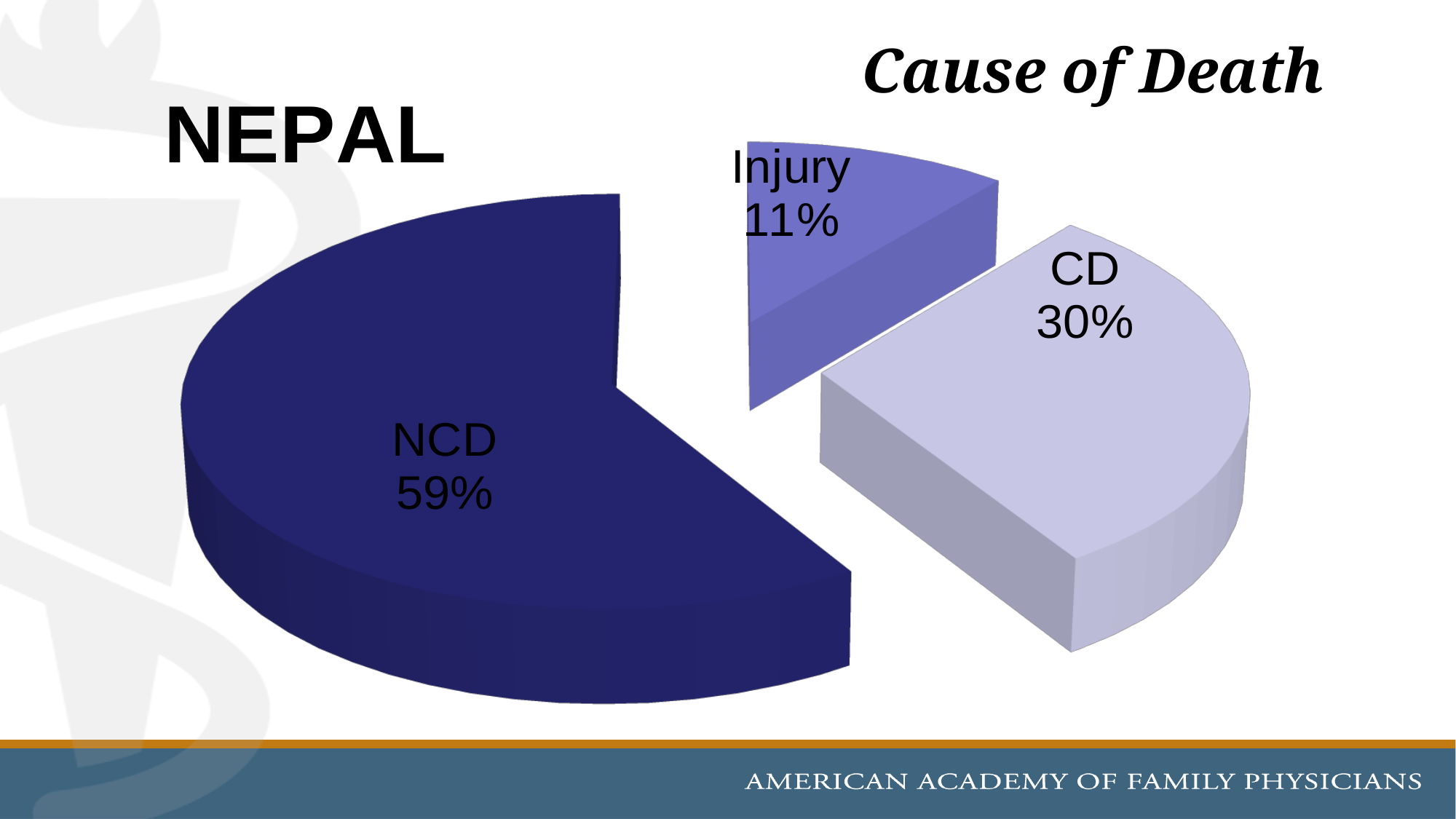
Which cause of death has the smallest share of the pie? Injury What percentage of deaths is attributed to Injury? 11% What is the difference in percentage points between CD and Injury? 19 What percentage of deaths is attributed to CD? 30% Which country does the chart refer to? Nepal How many slices does the pie chart have? 3 What is the difference in percentage points between NCD and CD? 29 Which cause of death has the largest share of the pie? NCD Which is larger, the share for CD or the share for Injury? CD What kind of chart is shown on the slide? Pie chart What is the title of the chart? Cause of Death What percentage of deaths is attributed to NCD? 59%